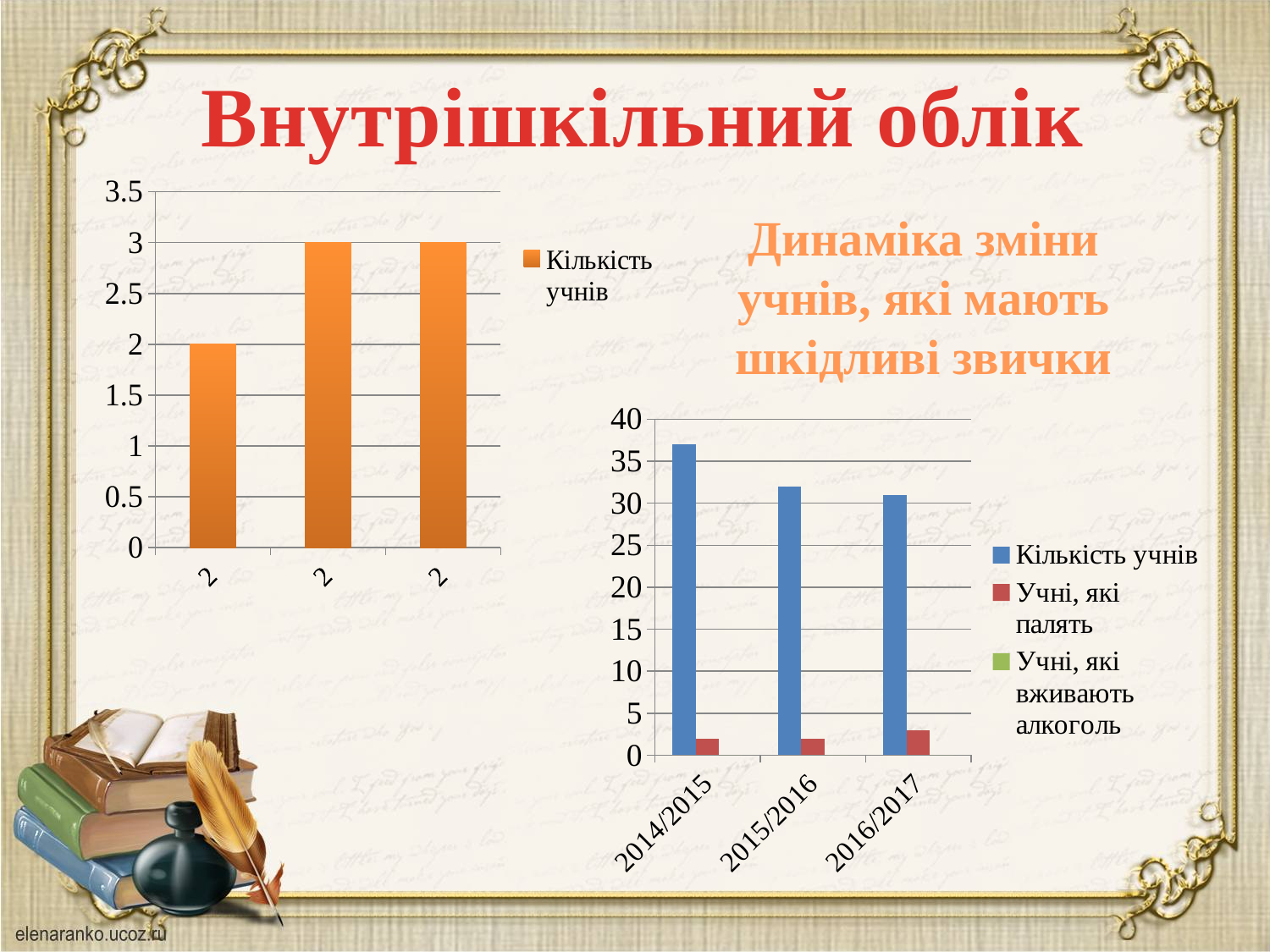
In the left chart, what is the difference between the second bar and the first bar? 1 In the left chart, what series name does the legend show? Кількість учнів What kind of chart is the left chart on the slide? bar chart In the right chart (Динаміка зміни учнів, які мають шкідливі звички), is the value of Кількість учнів for 2014/2015 greater or less than 35? greater In the right chart (Динаміка зміни учнів, які мають шкідливі звички), is the value of Кількість учнів for 2016/2017 greater or less than 35? less In the right chart (Динаміка зміни учнів, які мають шкідливі звички), how many series does the legend list? 3 In the right chart (Динаміка зміни учнів, які мають шкідливі звички), does the value of Кількість учнів rise or fall from 2014/2015 to 2016/2017? fall In the left chart, what is the value of the first (leftmost) bar? 2 In the left chart, what is the value of the third (rightmost) bar? 3 In the right chart (Динаміка зміни учнів, які мають шкідливі звички), how many categories are shown on the x axis? 3 In the right chart (Динаміка зміни учнів, які мають шкідливі звички), which category has the highest value for Кількість учнів? 2014/2015 In the left chart, how many bars are plotted? 3